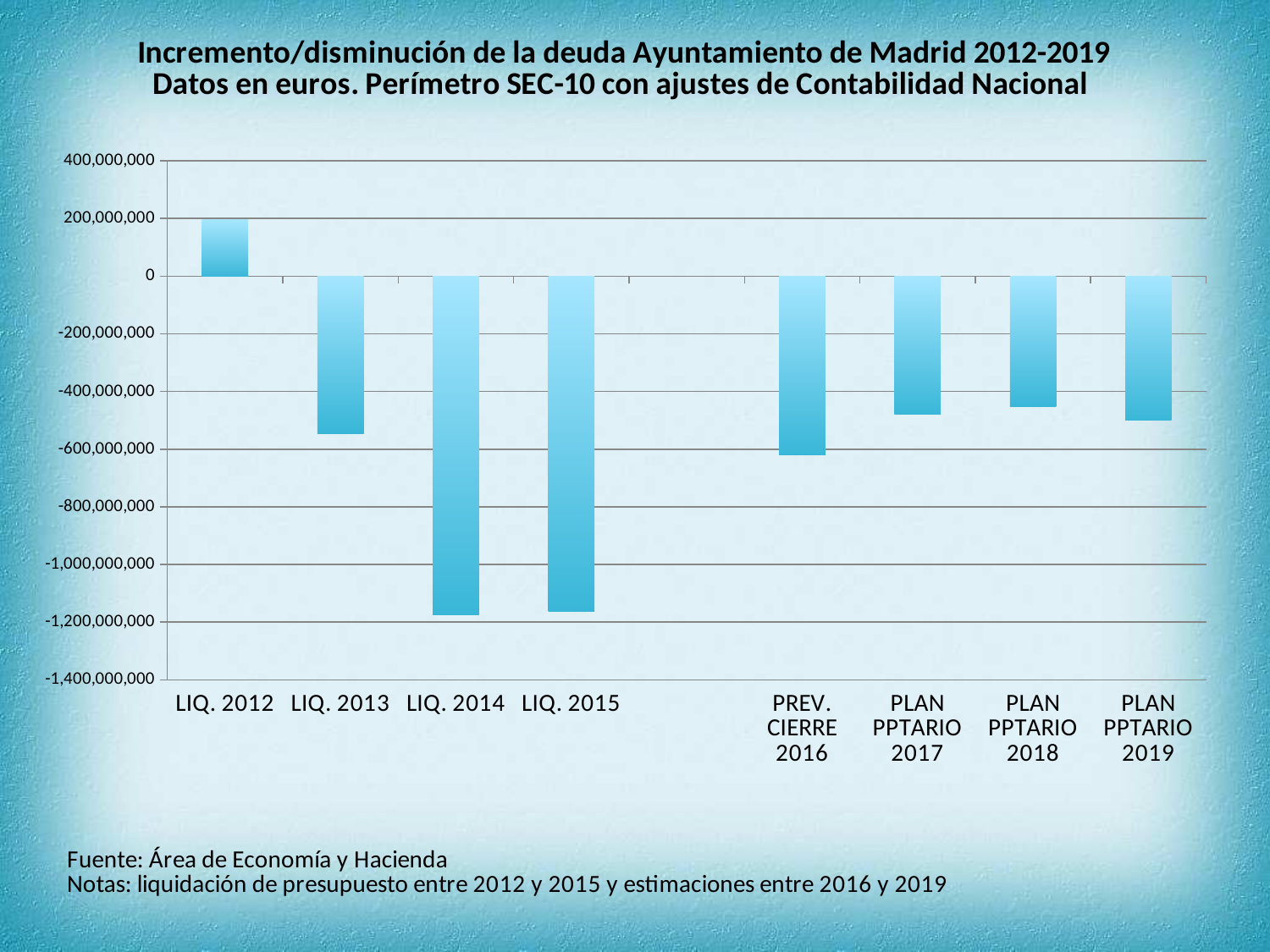
Is the value for PLAN PPTARIO 2018 greater or less than -600,000,000? greater How many labeled categories are shown on the x axis? 8 Is the value for LIQ. 2014 greater or less than -1,000,000,000? less What kind of chart is shown on the slide? bar chart Is the value for LIQ. 2012 greater or less than 0? greater Which is larger, the value for LIQ. 2013 or the value for LIQ. 2014? LIQ. 2013 Which is larger, the value for LIQ. 2013 or the value for PREV. CIERRE 2016? LIQ. 2013 Do the values rise or fall from LIQ. 2012 to LIQ. 2014? fall Which category has the highest value? LIQ. 2012 What is the lowest value shown on the vertical axis? -1,400,000,000